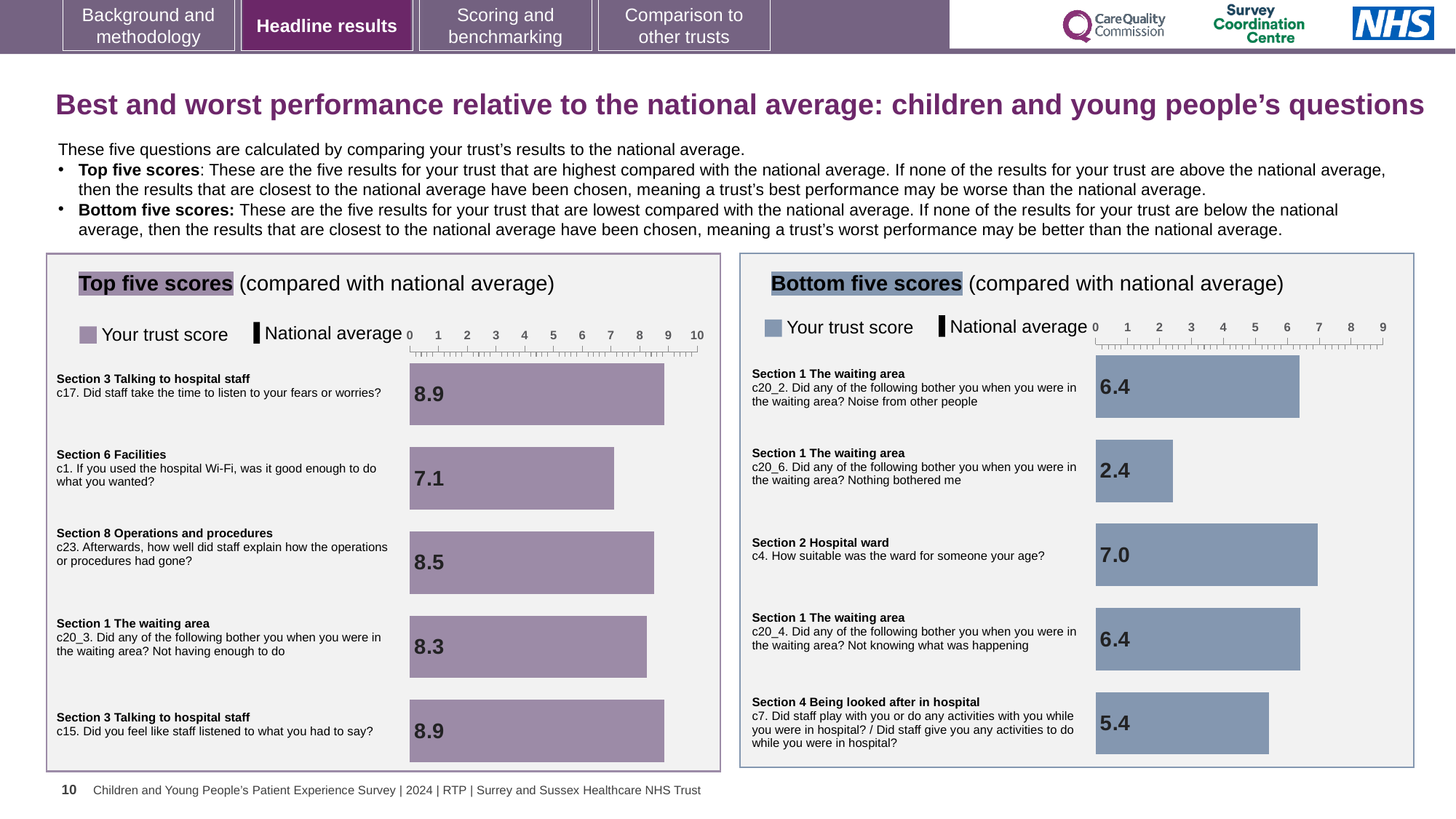
In the Top five scores chart, which has the higher trust score: c23 (how well staff explained how operations had gone) or c20_3 (Not having enough to do)? c23 (8.5) What type of chart is the Bottom five scores chart? Bar chart How many questions are shown in the Top five scores chart? 5 In the Top five scores chart, which question has the lowest trust score? c1. If you used the hospital Wi-Fi, was it good enough to do what you wanted? In the Top five scores chart, what is the trust score for c1 (If you used the hospital Wi-Fi, was it good enough to do what you wanted?)? 7.1 In the Bottom five scores chart, which question has the lowest trust score? c20_6. Nothing bothered me In the Top five scores chart, what is the difference between the trust score for c17 (listen to your fears or worries) and c1 (hospital Wi-Fi)? 1.8 What two entries does the legend of the Top five scores chart list? Your trust score and National average In the Bottom five scores chart, is the trust score for c7 (Did staff play with you or do any activities with you) greater or less than 6? less In the Bottom five scores chart, what is the difference between the trust score for c4 (ward suitable for your age) and c20_6 (Nothing bothered me)? 4.6 In the Bottom five scores chart, which question has the highest trust score? c4. How suitable was the ward for someone your age? In the Bottom five scores chart, what is the trust score for c4 (How suitable was the ward for someone your age?)? 7.0